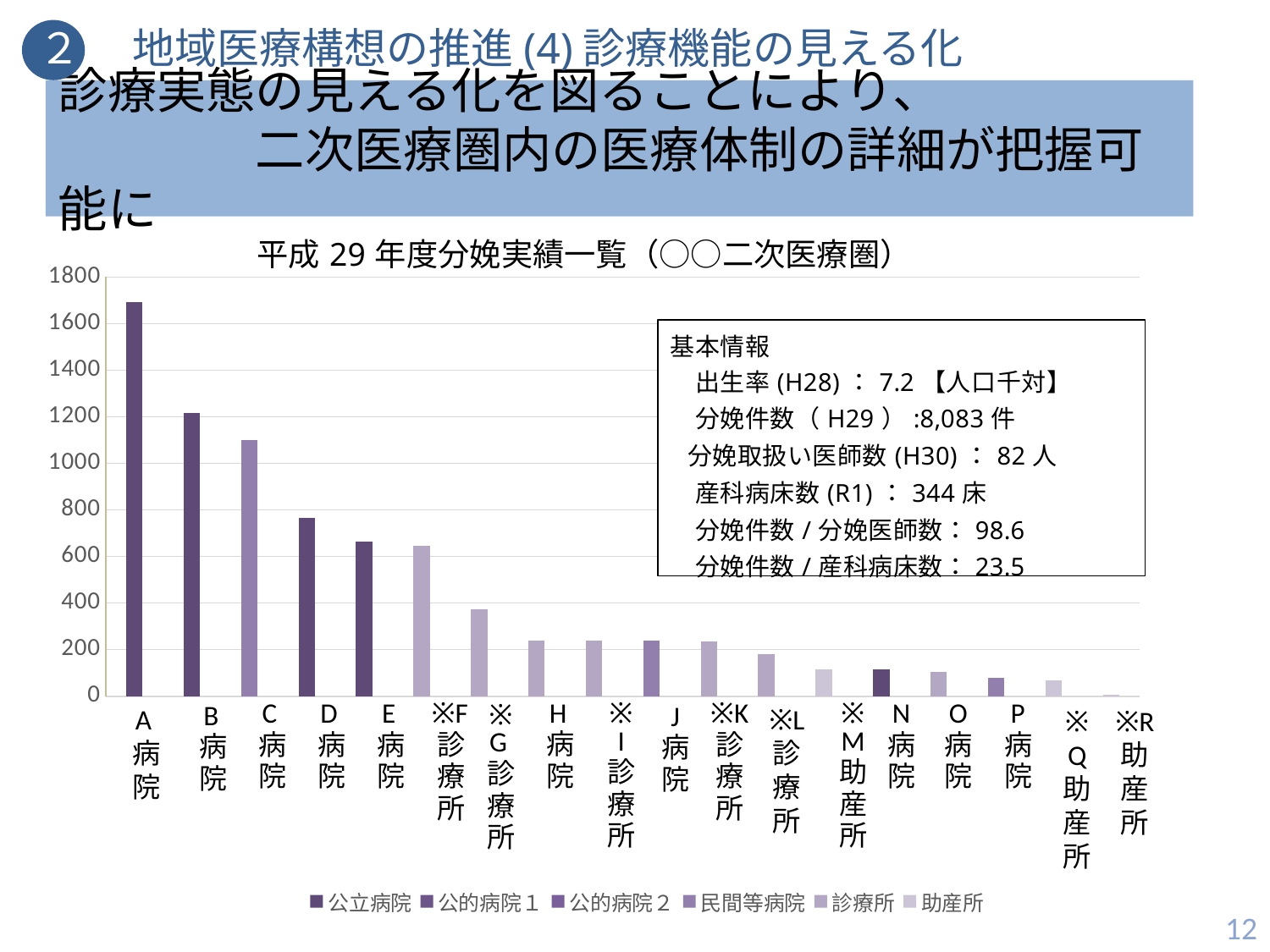
Do the values generally rise or fall moving from left to right along the x axis? fall How many series does the chart legend list? 6 Which category has the lowest value in the chart? ※R助産所 Which category has the highest value in the chart? A病院 What is the title of the chart? 平成29年度分娩実績一覧（○○二次医療圏） Is the value for D病院 greater or less than 800? less How many categories are plotted along the x axis of the chart? 18 Is the value for C病院 greater or less than 1000? greater What kind of chart is shown on the slide? bar chart Which has the larger value, D病院 or ※G診療所? D病院 Is the value for A病院 greater or less than 1600? greater